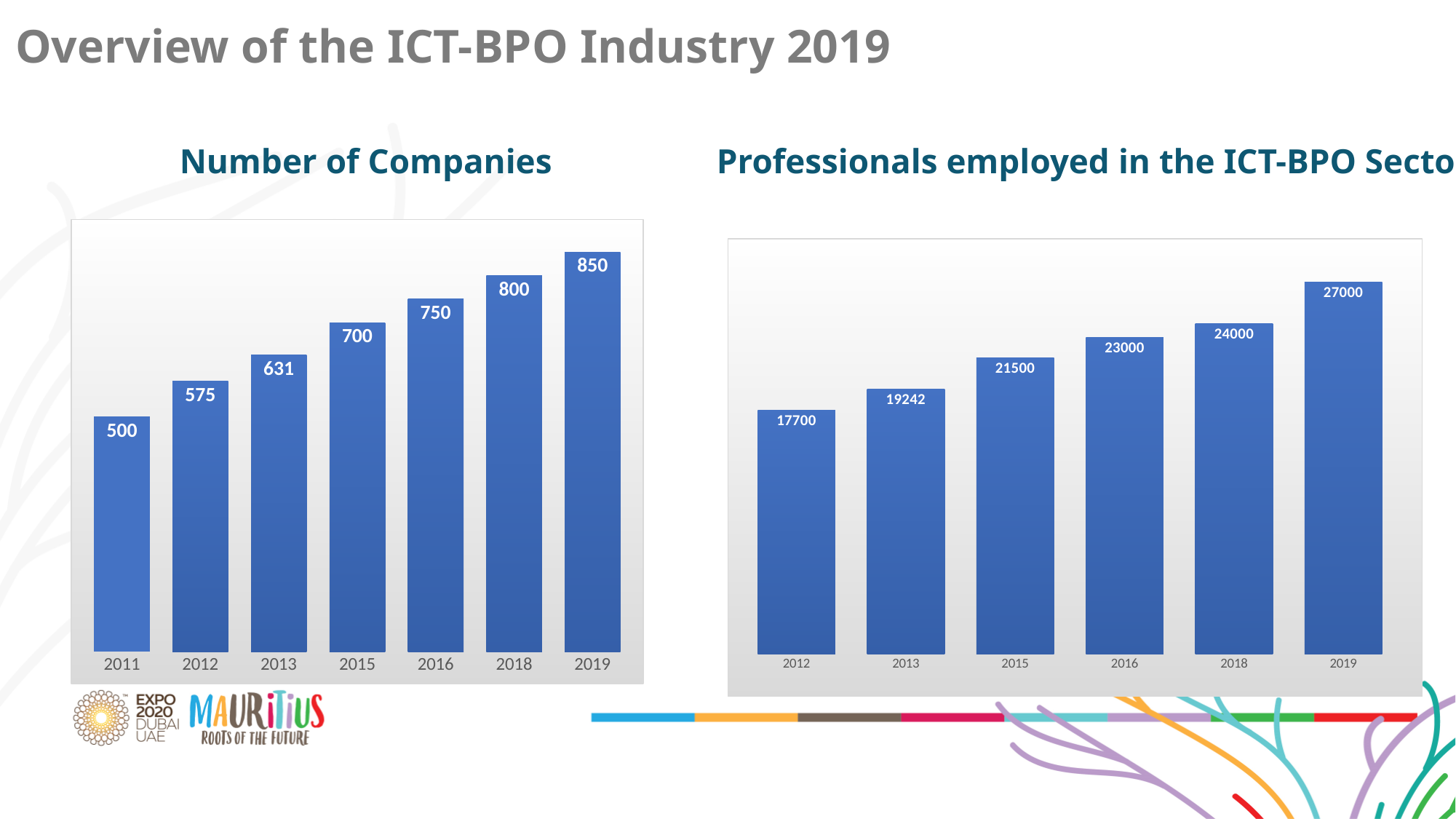
In the 'Professionals employed in the ICT-BPO Sector' chart, which year has the highest value? 2019 In the 'Professionals employed in the ICT-BPO Sector' chart, what is the difference between the values for 2019 and 2018? 3000 In the 'Number of Companies' chart, what is the value for 2013? 631 What kind of chart is the 'Number of Companies' chart? bar chart What is the title of the chart on the left of the slide? Number of Companies In the 'Professionals employed in the ICT-BPO Sector' chart, which is larger, the value for 2015 or the value for 2016? 2016 In the 'Professionals employed in the ICT-BPO Sector' chart, how many years are shown? 6 In the 'Number of Companies' chart, how many bars are shown? 7 In the 'Number of Companies' chart, what is the difference between the values for 2019 and 2011? 350 In the 'Professionals employed in the ICT-BPO Sector' chart, what is the value for 2013? 19242 In the 'Number of Companies' chart, do the values rise or fall from 2011 to 2019? rise In the 'Number of Companies' chart, which year has the lowest value? 2011